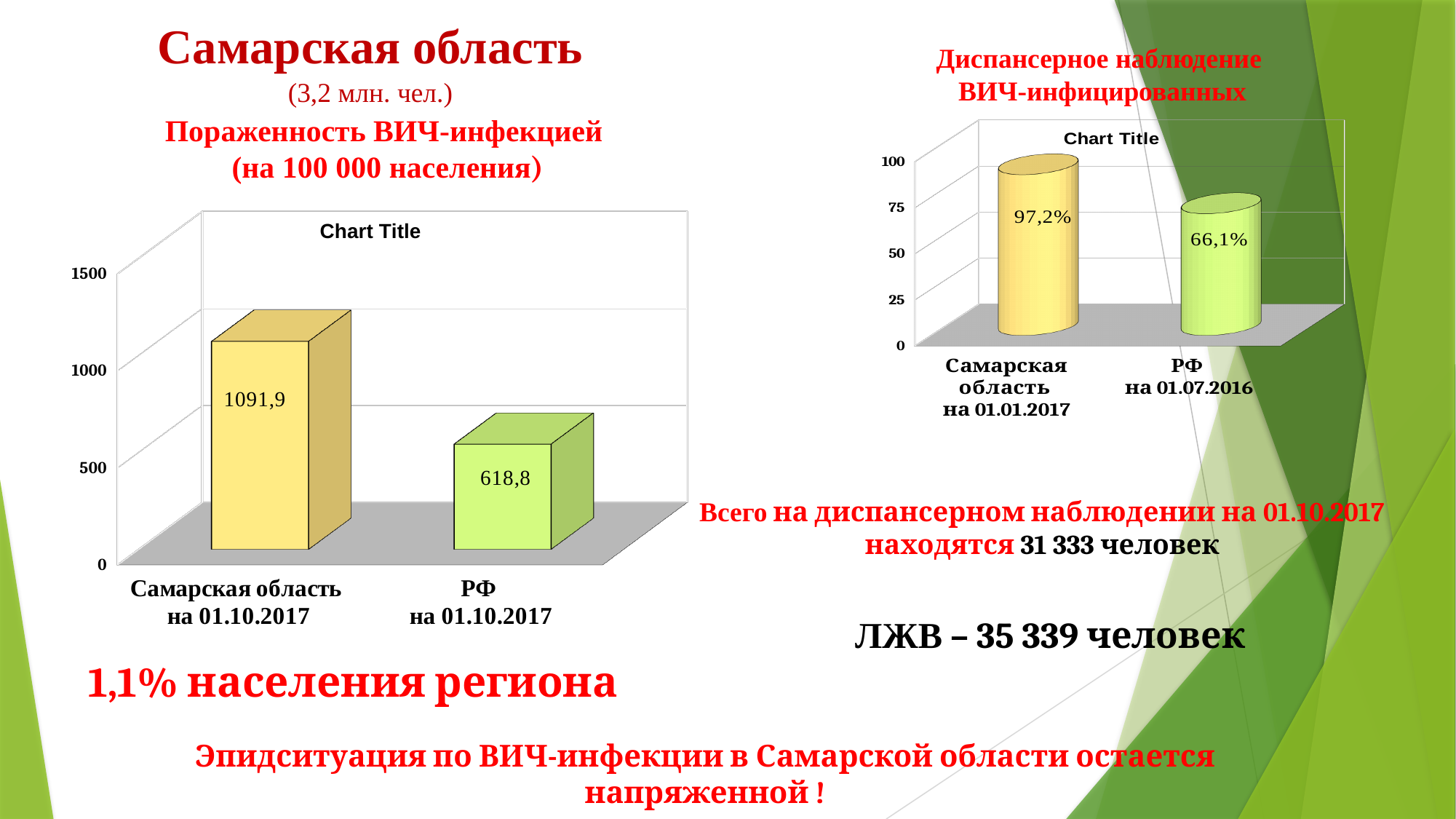
In the right chart (Диспансерное наблюдение ВИЧ-инфицированных), what is the difference between the Самарская область value and the РФ value? 31,1% In the left chart (Пораженность ВИЧ-инфекцией), is the value for РФ на 01.10.2017 greater or less than 1000? less In the right chart (Диспансерное наблюдение ВИЧ-инфицированных), what is the highest value shown on the vertical axis? 100 In the left chart (Пораженность ВИЧ-инфекцией), what is the value for Самарская область на 01.10.2017? 1091,9 In the left chart (Пораженность ВИЧ-инфекцией), what is the difference between the Самарская область value and the РФ value? 473,1 In the right chart (Диспансерное наблюдение ВИЧ-инфицированных), what is the value for Самарская область на 01.01.2017? 97,2% In the left chart (Пораженность ВИЧ-инфекцией), which category has the higher value? Самарская область на 01.10.2017 In the right chart (Диспансерное наблюдение ВИЧ-инфицированных), which category has the lower value? РФ на 01.07.2016 In the left chart (Пораженность ВИЧ-инфекцией), what is the value for РФ на 01.10.2017? 618,8 What type of chart is the left chart (Пораженность ВИЧ-инфекцией)? bar chart In the left chart (Пораженность ВИЧ-инфекцией), how many bars are plotted? 2 In the right chart (Диспансерное наблюдение ВИЧ-инфицированных), what is the value for РФ на 01.07.2016? 66,1%